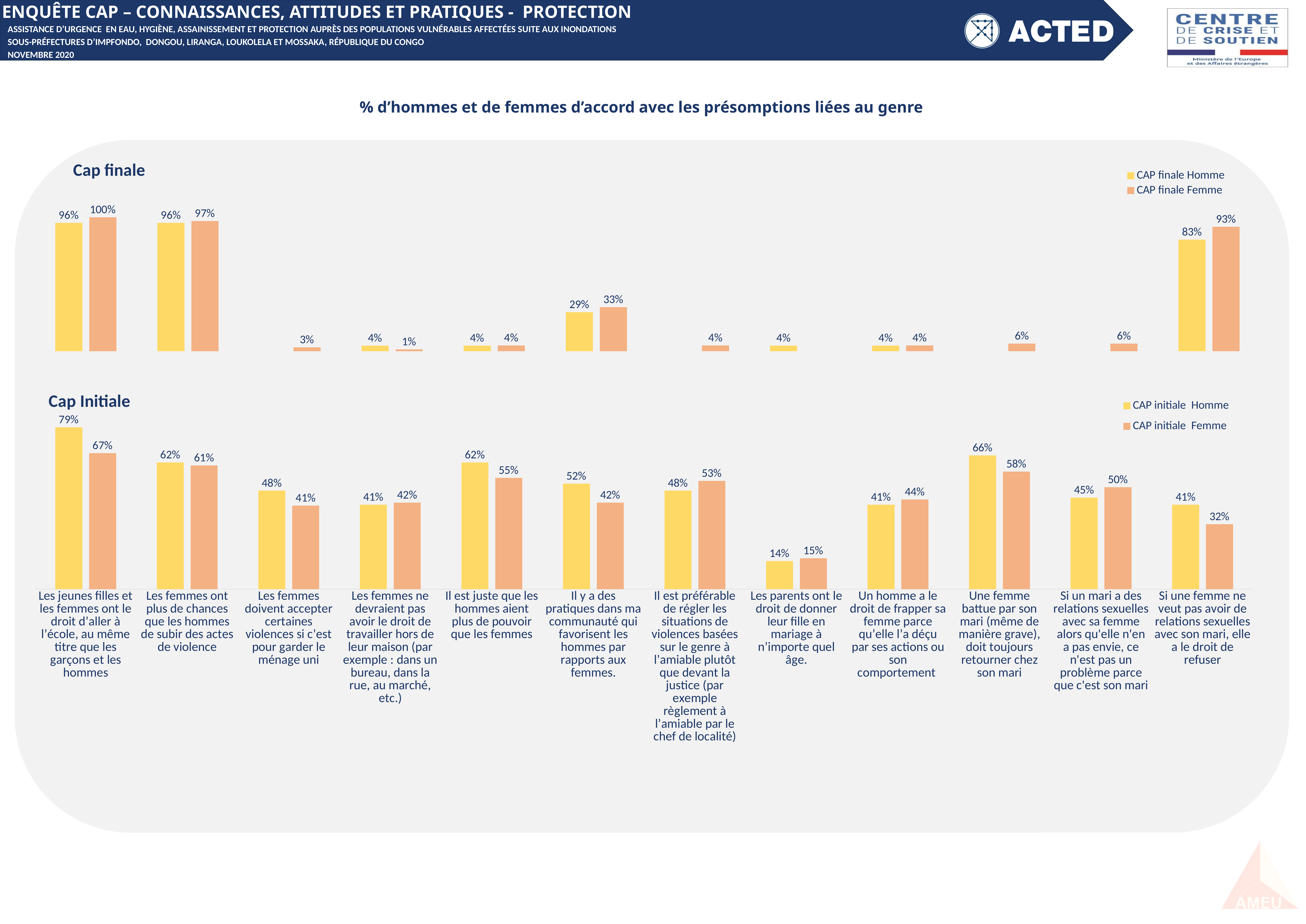
In the Cap finale chart, what is the difference between the CAP finale Femme and CAP finale Homme values for 'Si une femme ne veut pas avoir de relations sexuelles avec son mari, elle a le droit de refuser'? 10% How many series does the legend of the Cap finale chart list? 2 What type of chart is the Cap finale chart? Bar chart In the Cap Initiale chart, which is larger for 'Il y a des pratiques dans ma communauté qui favorisent les hommes par rapports aux femmes.': CAP initiale Homme or CAP initiale Femme? CAP initiale Homme In the Cap Initiale chart, which statement has the highest CAP initiale Homme value? Les jeunes filles et les femmes ont le droit d'aller à l'école, au même titre que les garçons et les hommes In the Cap Initiale chart, what is the difference between the CAP initiale Homme and CAP initiale Femme values for 'Les jeunes filles et les femmes ont le droit d'aller à l'école, au même titre que les garçons et les hommes'? 12% In the Cap finale chart, what is the value for CAP finale Femme for 'Les jeunes filles et les femmes ont le droit d'aller à l'école, au même titre que les garçons et les hommes'? 100% In the Cap Initiale chart, what is the value for CAP initiale Femme for 'Si une femme ne veut pas avoir de relations sexuelles avec son mari, elle a le droit de refuser'? 32% In the Cap Initiale chart, what is the value for CAP initiale Homme for 'Une femme battue par son mari (même de manière grave), doit toujours retourner chez son mari'? 66% How many statements (categories) are shown along the x axis of the Cap Initiale chart? 12 In the Cap finale chart, what is the value for CAP finale Homme for 'Il y a des pratiques dans ma communauté qui favorisent les hommes par rapports aux femmes.'? 29% In the Cap Initiale chart, which statement has the lowest CAP initiale Femme value? Les parents ont le droit de donner leur fille en mariage à n'importe quel âge.